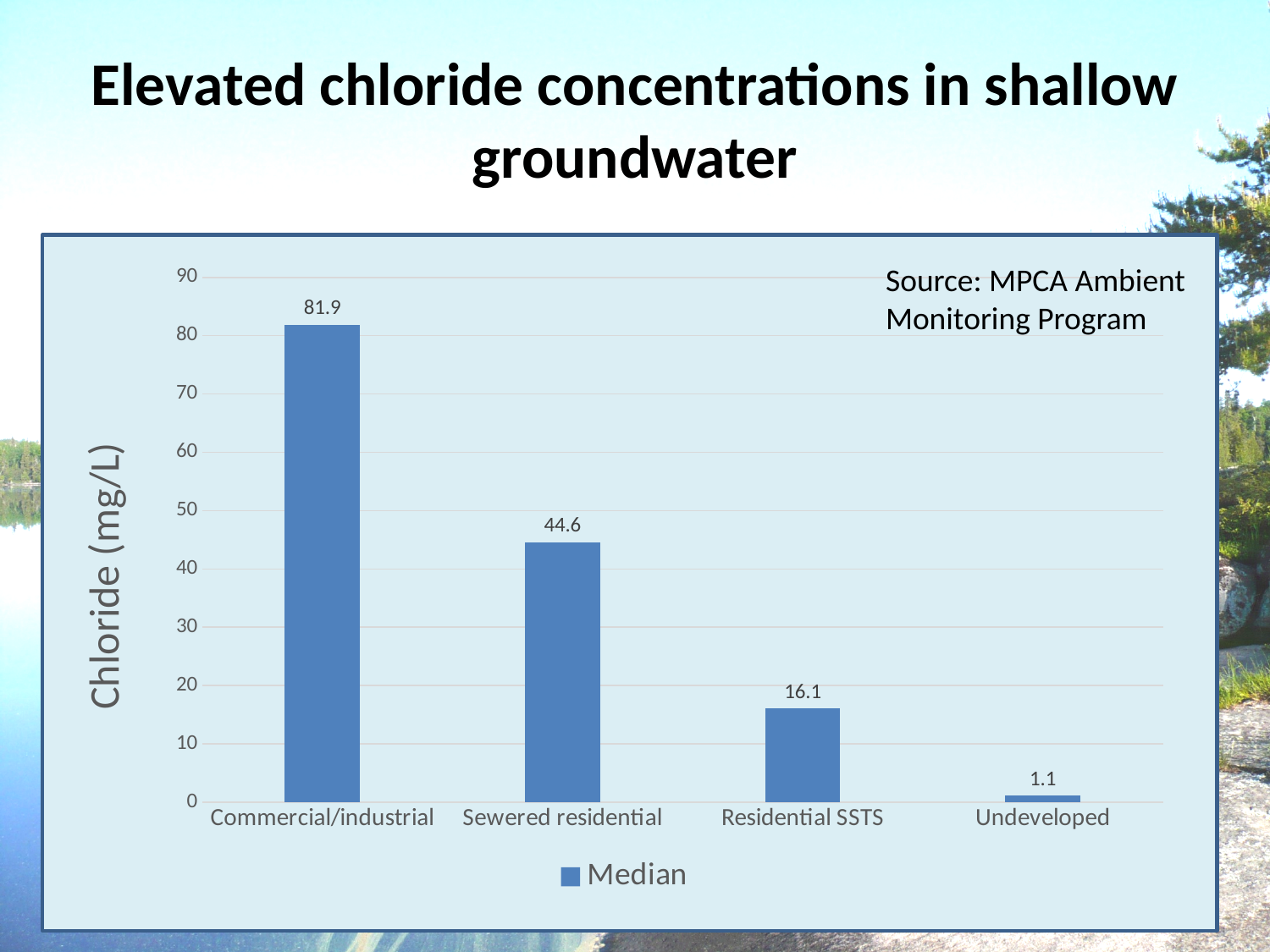
Which category has the highest median chloride concentration? Commercial/industrial Is the value for Sewered residential greater or less than 40? greater What is the difference between the median chloride values for Commercial/industrial and Sewered residential? 37.3 Which has a larger median chloride concentration, Sewered residential or Residential SSTS? Sewered residential What is the median chloride concentration for Residential SSTS? 16.1 What is the median chloride concentration for Undeveloped? 1.1 What is the median chloride concentration for Sewered residential? 44.6 What kind of chart is shown on the slide? Bar chart What is the label on the y axis of the chart? Chloride (mg/L) How many land-use categories are shown on the x axis? 4 What is the median chloride concentration for Commercial/industrial? 81.9 Which category has the lowest median chloride concentration? Undeveloped